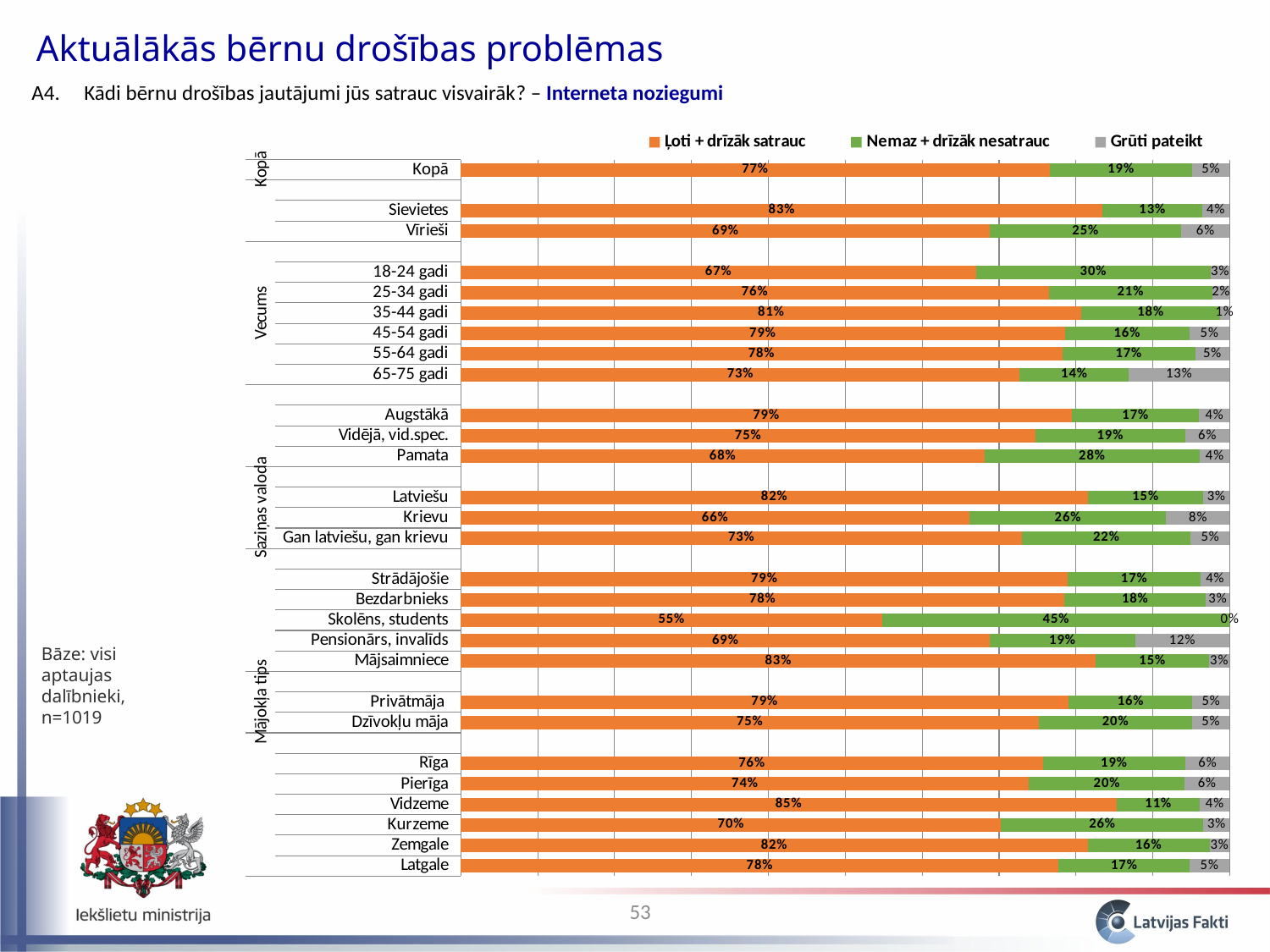
Which has a larger "Nemaz + drīzāk nesatrauc" value, Krievu or Latviešu? Krievu What kind of chart is shown on the slide? Stacked bar chart What is the value of "Ļoti + drīzāk satrauc" for Kopā? 77% What is the value of "Ļoti + drīzāk satrauc" for Mājsaimniece? 83% What is the total of the stacked bar for Pensionārs, invalīds? 100% What is the value of "Nemaz + drīzāk nesatrauc" for Skolēns, students? 45% Which category has the lowest value for "Ļoti + drīzāk satrauc"? Skolēns, students What is the value of "Grūti pateikt" for 65-75 gadi? 13% How many series does the legend list? 3 What is the difference between the "Ļoti + drīzāk satrauc" values for Sievietes and Vīrieši? 14% Which colour represents the "Grūti pateikt" series? Grey Which category has the highest value for "Ļoti + drīzāk satrauc"? Vidzeme